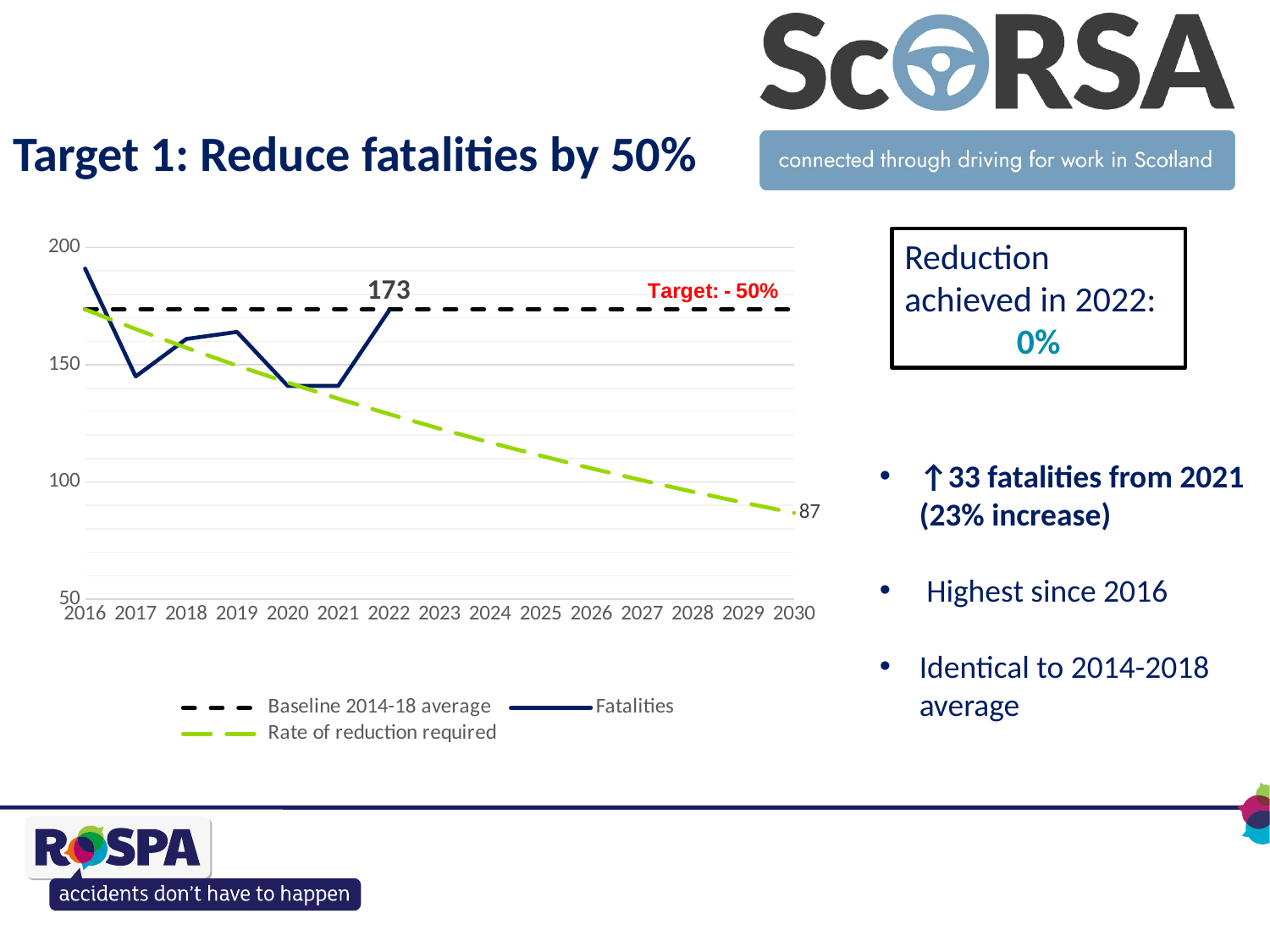
How many series does the legend list? 3 Does the Rate of reduction required line rise or fall from 2016 to 2030? falls How many years are shown on the x axis? 15 Which series is drawn as a green dashed line? Rate of reduction required Is the Fatalities value for 2021 greater or less than 150? less What kind of chart is shown on the slide? Line chart Which is larger, the Fatalities value for 2021 or for 2022? 2022 What value does the Rate of reduction required line reach in 2030? 87 Is the Fatalities value for 2016 greater or less than 150? greater What is the value of the Fatalities series in 2022? 173 What is the difference between the 2022 Fatalities value and the 2030 Rate of reduction required value? 86 In which year is the Fatalities series at its highest? 2016